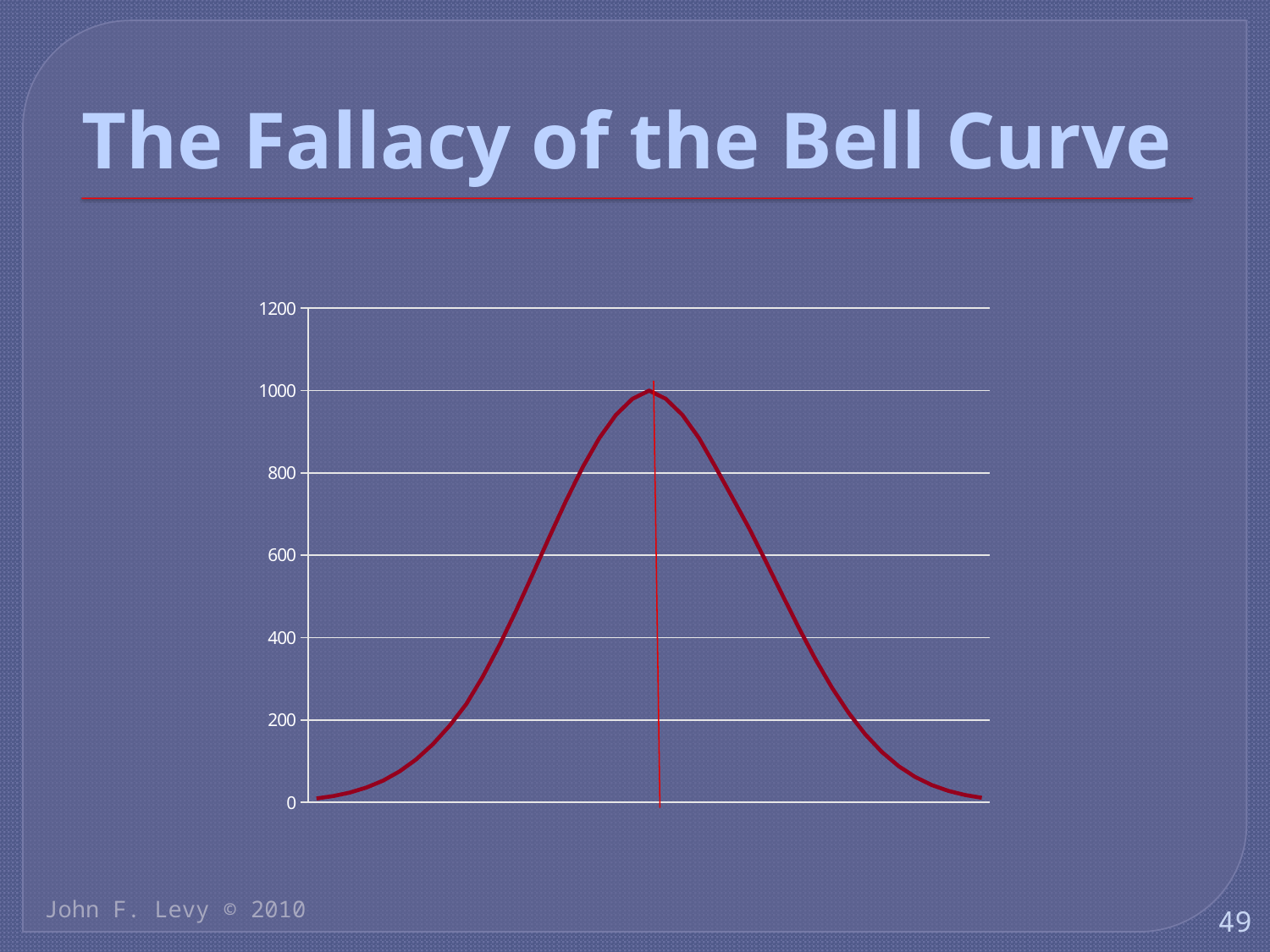
What is the highest value labelled on the vertical axis of the chart? 1200 What is the title of the slide containing the chart? The Fallacy of the Bell Curve Is the value at the left end of the curve greater or less than 200? less Is the peak value of the curve greater or less than 800? greater Does the curve rise or fall as it moves from the left edge toward the centre of the chart? rise Is the peak of the curve greater or less than 1200? less What kind of chart is shown on the slide? line chart How many labelled tick marks are there on the vertical axis? 7 Does the curve rise or fall as it moves from the centre toward the right edge of the chart? fall What value does the peak of the curve reach on the vertical axis? 1000